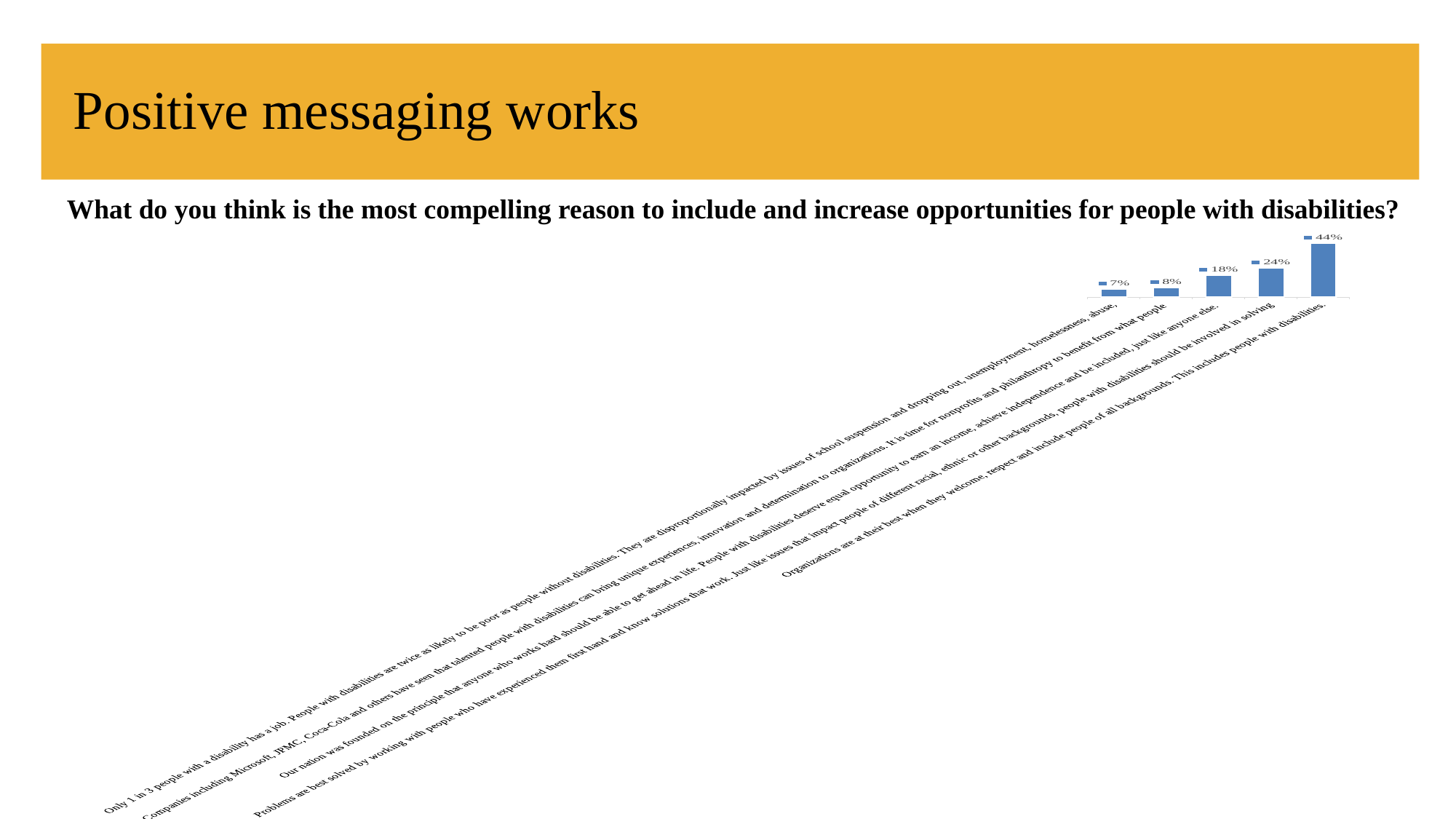
What is the value for the statement beginning "Companies including Microsoft, JPMC, Coca-Cola and others"? 8% Which statement has the highest value in the chart? Organizations are at their best when they welcome, respect and include people of all backgrounds. This includes people with disabilities. What is the value for the statement beginning "Only 1 in 3 people with a disability has a job"? 7% What is the difference between the highest value (44%) and the second highest value (24%)? 20% Which statement has the lowest value in the chart? Only 1 in 3 people with a disability has a job... What is the value for the statement beginning "Our nation was founded on the principle that anyone who works hard should be able to get ahead in life"? 18% Do the bar values rise or fall from left to right across the chart? rise What kind of chart is shown on the slide? bar chart What is the value for the statement beginning "Organizations are at their best when they welcome, respect and include people of all backgrounds"? 44% What is the value for the statement beginning "Problems are best solved by working with people who have experienced them first hand"? 24% How many bars (response options) does the chart show? 5 What question is the chart answering, as stated above it? What do you think is the most compelling reason to include and increase opportunities for people with disabilities?